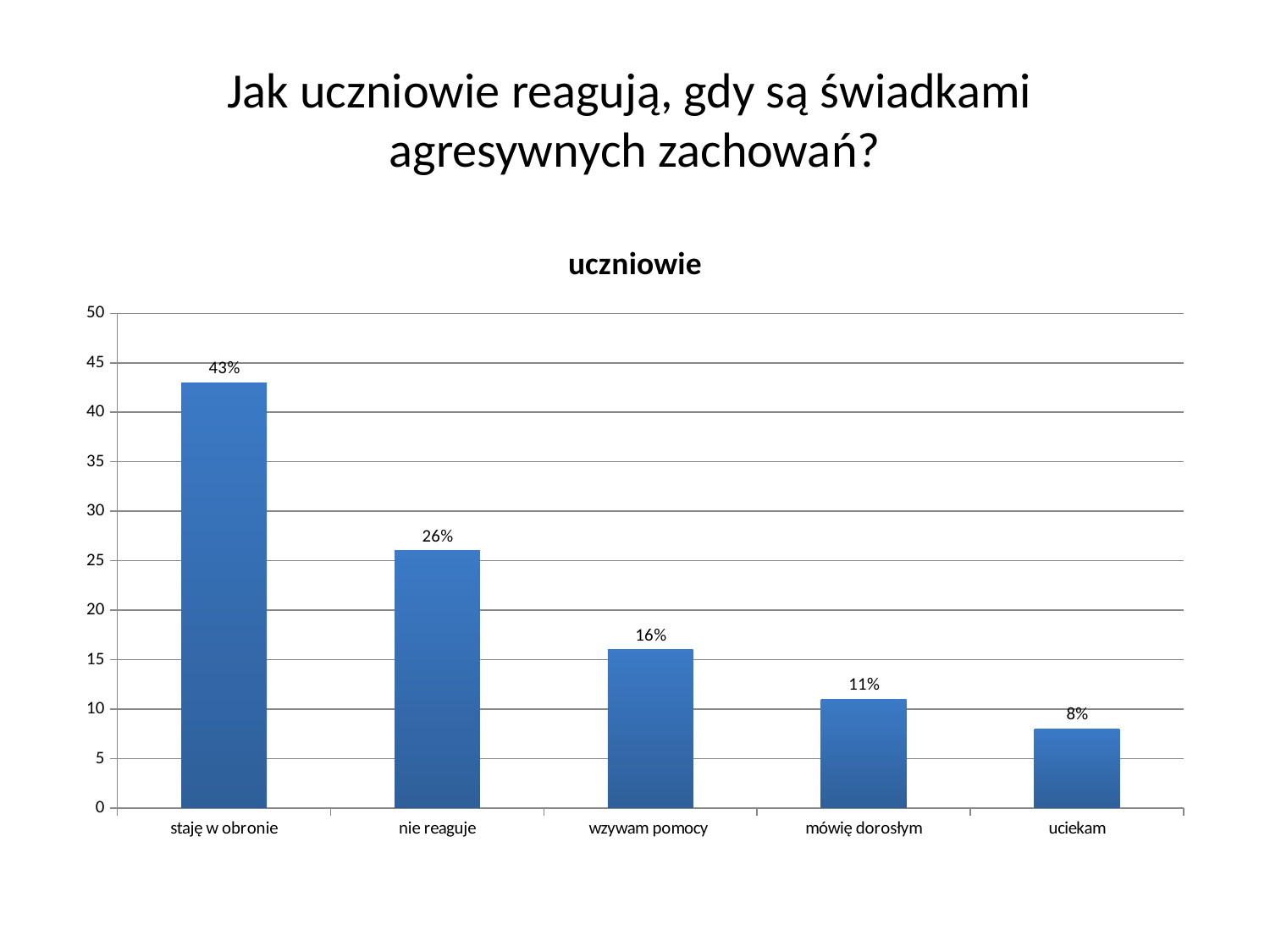
What is the value for "nie reaguje"? 26% Is the value for "nie reaguje" greater or less than 25? greater Which is larger, the value for "mówię dorosłym" or the value for "wzywam pomocy"? wzywam pomocy What kind of chart is shown on the slide? bar chart What is the value for "staję w obronie"? 43% What is the value for "wzywam pomocy"? 16% What is the title of the chart? uczniowie How many categories are shown on the x axis? 5 Which category has the highest value? staję w obronie What is the value for "uciekam"? 8% What is the difference between the values for "staję w obronie" and "nie reaguje"? 17% Which category has the lowest value? uciekam